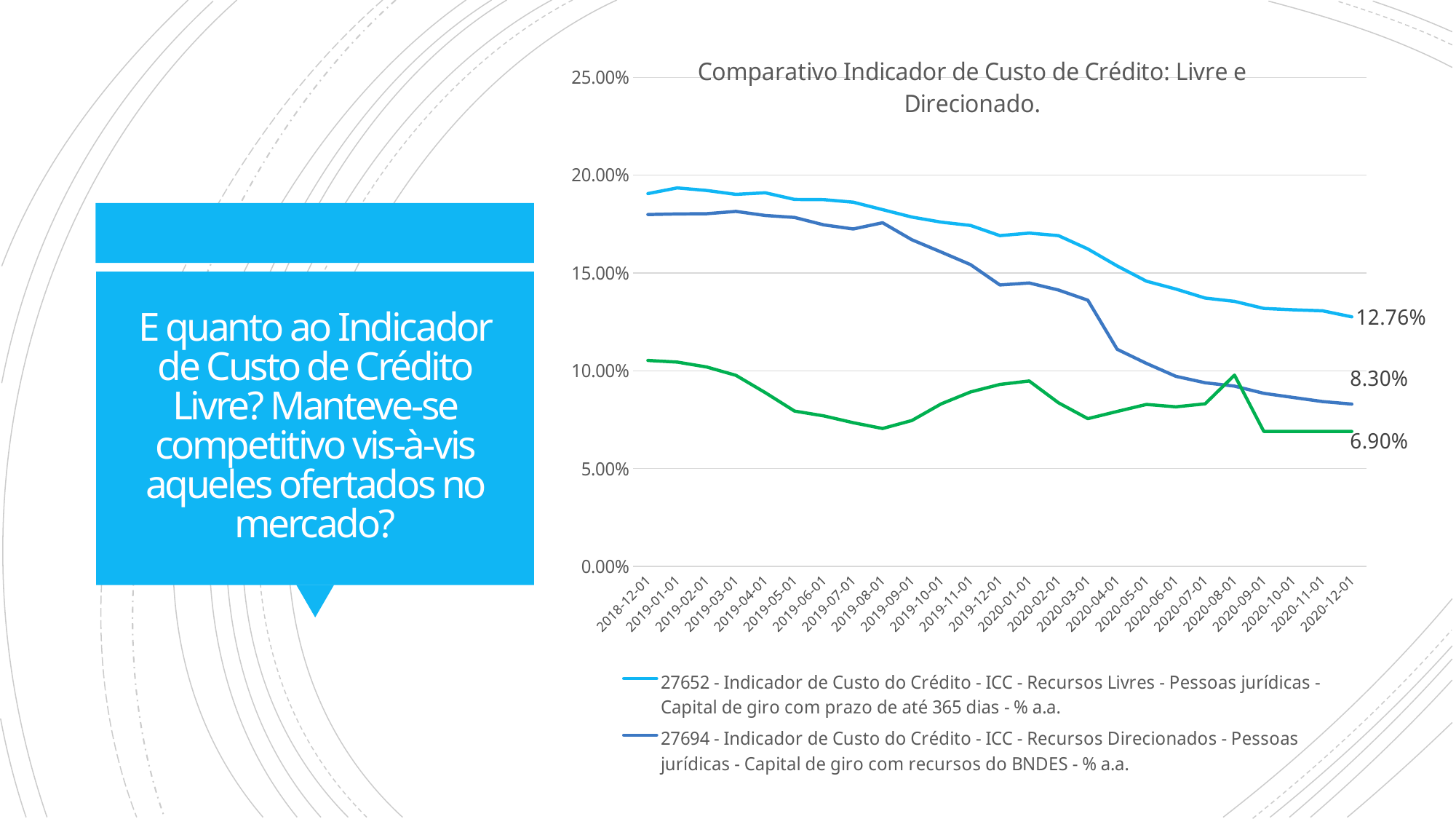
What is the value of series 27694 (Recursos Direcionados) at 2020-12-01? 8.30% How many series does the chart legend list? 2 How many dates are shown on the x axis of the chart? 25 What is the difference between the 2020-12-01 values of series 27652 (12.76%) and series 27694 (8.30%)? 4.46 percentage points Is the value of series 27694 (Recursos Direcionados) at 2020-04-01 greater or less than 15.00%? less At 2020-12-01, which series has the larger value: 27652 (Recursos Livres) or 27694 (Recursos Direcionados)? 27652 (Recursos Livres) What is the value of series 27652 (Recursos Livres) at 2020-12-01? 12.76% Is the value of series 27652 (Recursos Livres) at 2018-12-01 greater or less than 15.00%? greater What is the title of the chart? Comparativo Indicador de Custo de Crédito: Livre e Direcionado. What type of chart is shown on the slide? line chart Does series 27652 (Recursos Livres) generally rise or fall from 2018-12-01 to 2020-12-01? fall What value is labelled at the end of the green line at 2020-12-01? 6.90%